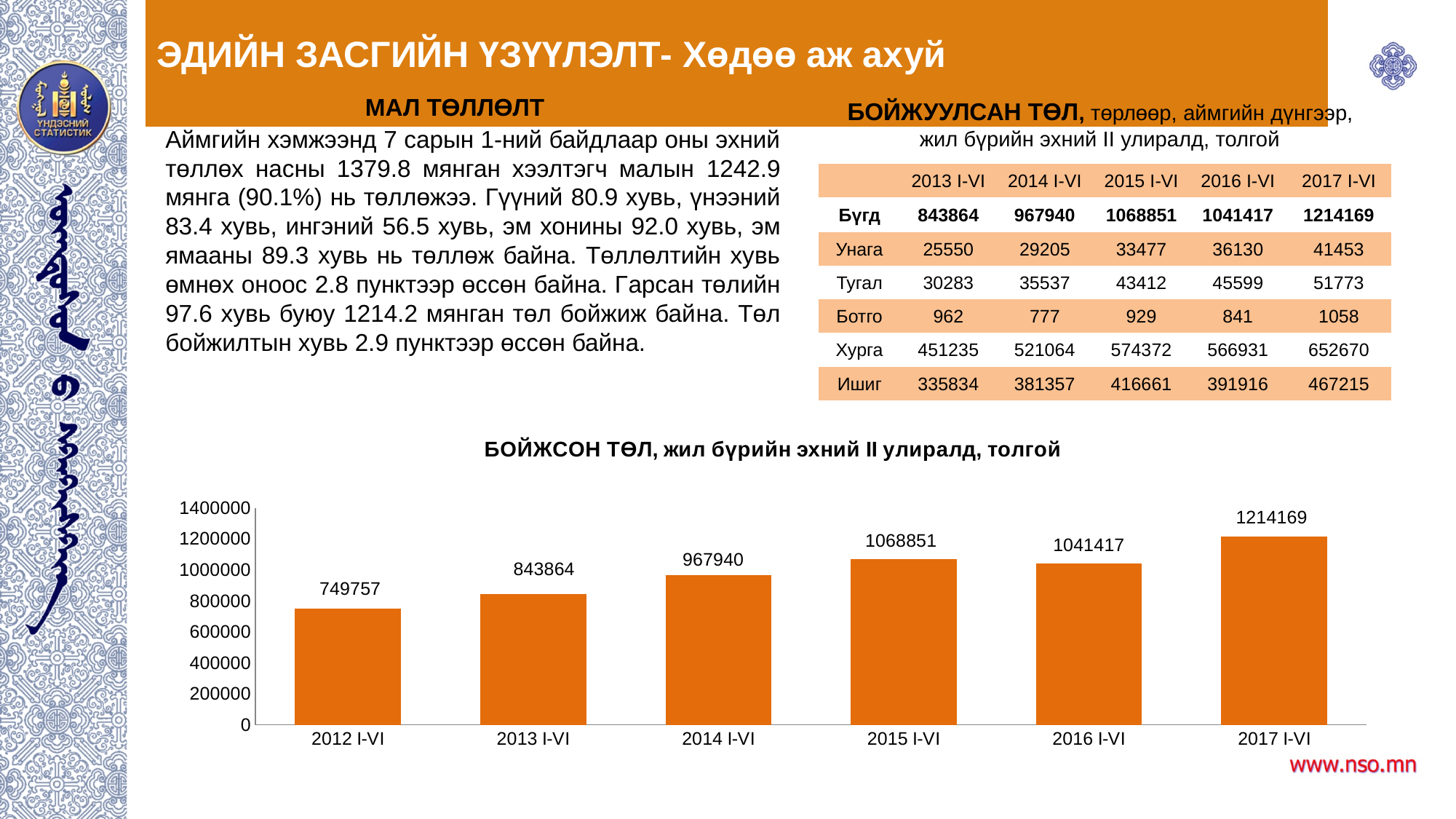
What is the title of the chart at the bottom of the slide? БОЙЖСОН ТӨЛ, жил бүрийн эхний II улиралд, толгой What is the value for 2017 I-VI in the bar chart? 1214169 What is the value for 2015 I-VI in the bar chart? 1068851 Is the value for 2014 I-VI in the bar chart greater or less than 1000000? less What type of chart is shown at the bottom of the slide? bar chart What is the difference between the values for 2017 I-VI and 2016 I-VI in the bar chart? 172752 Which period has the lowest value in the bar chart? 2012 I-VI Which period has the highest value in the bar chart? 2017 I-VI How many bars are shown in the bar chart? 6 What is the difference between the values for 2013 I-VI and 2012 I-VI in the bar chart? 94107 Which is larger in the bar chart, the value for 2015 I-VI or 2016 I-VI? 2015 I-VI What is the value for 2012 I-VI in the bar chart? 749757